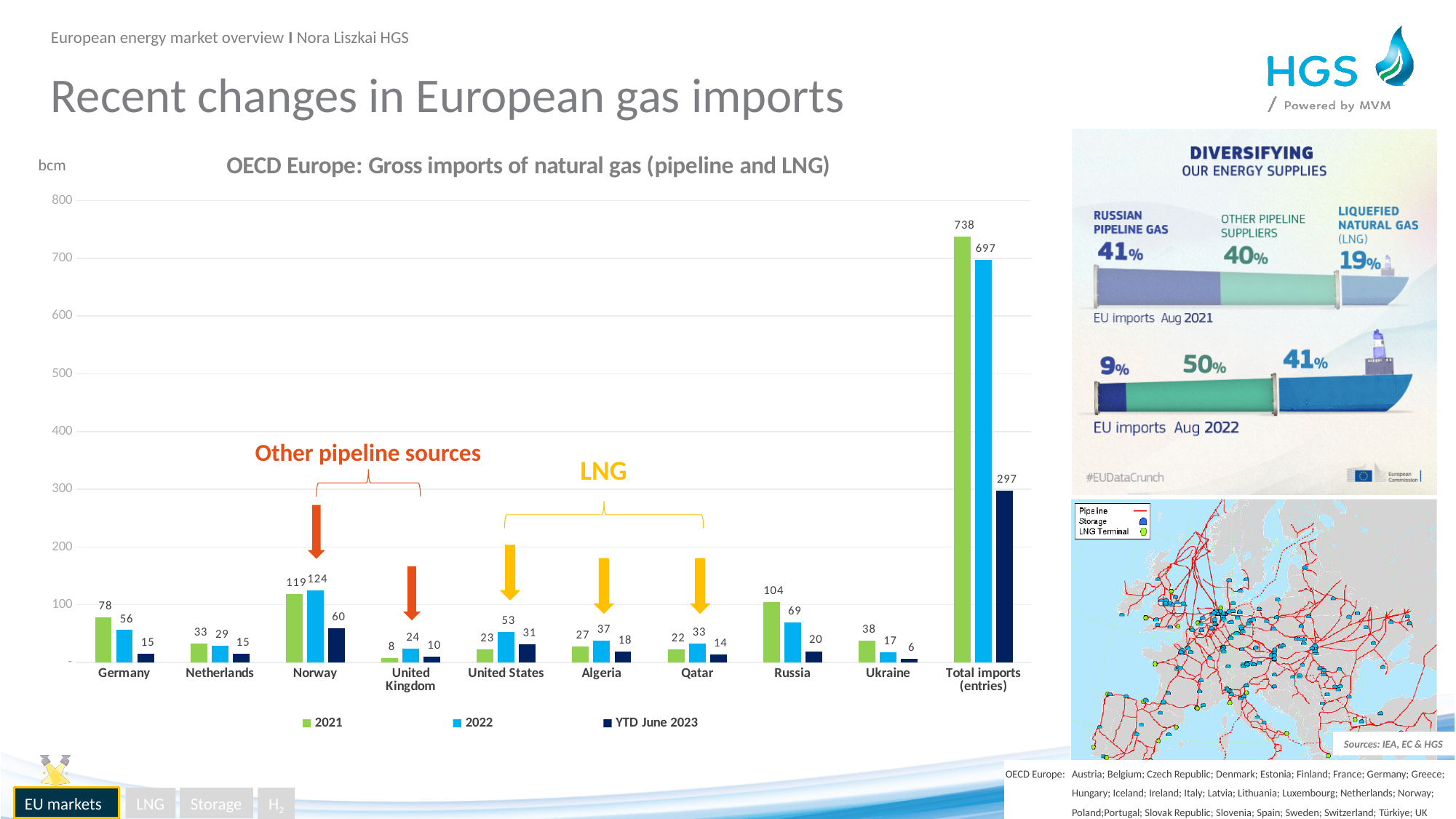
Excluding the Total imports (entries) bars, which country had the highest 2021 value in the OECD Europe gross imports chart? Norway Is the 2022 value for Total imports (entries) in the OECD Europe gross imports chart greater or less than 600? greater What type of chart is the OECD Europe gross imports chart? Bar chart What is the difference between the 2021 and 2022 values for Russia in the OECD Europe gross imports chart? 35 How many series does the legend of the OECD Europe gross imports chart list? 3 What was the value for Russia in 2021 in the OECD Europe gross imports chart? 104 What was the value for Norway in 2022 in the OECD Europe gross imports chart? 124 How many categories are shown on the x axis of the OECD Europe gross imports chart? 10 What is the YTD June 2023 value for Total imports (entries) in the OECD Europe gross imports chart? 297 Which country had the lowest YTD June 2023 value in the OECD Europe gross imports chart? Ukraine By how much did Total imports (entries) fall from 2021 to 2022 in the OECD Europe gross imports chart? 41 In the OECD Europe gross imports chart, which was larger in 2022: the value for the United States or the value for Algeria? United States